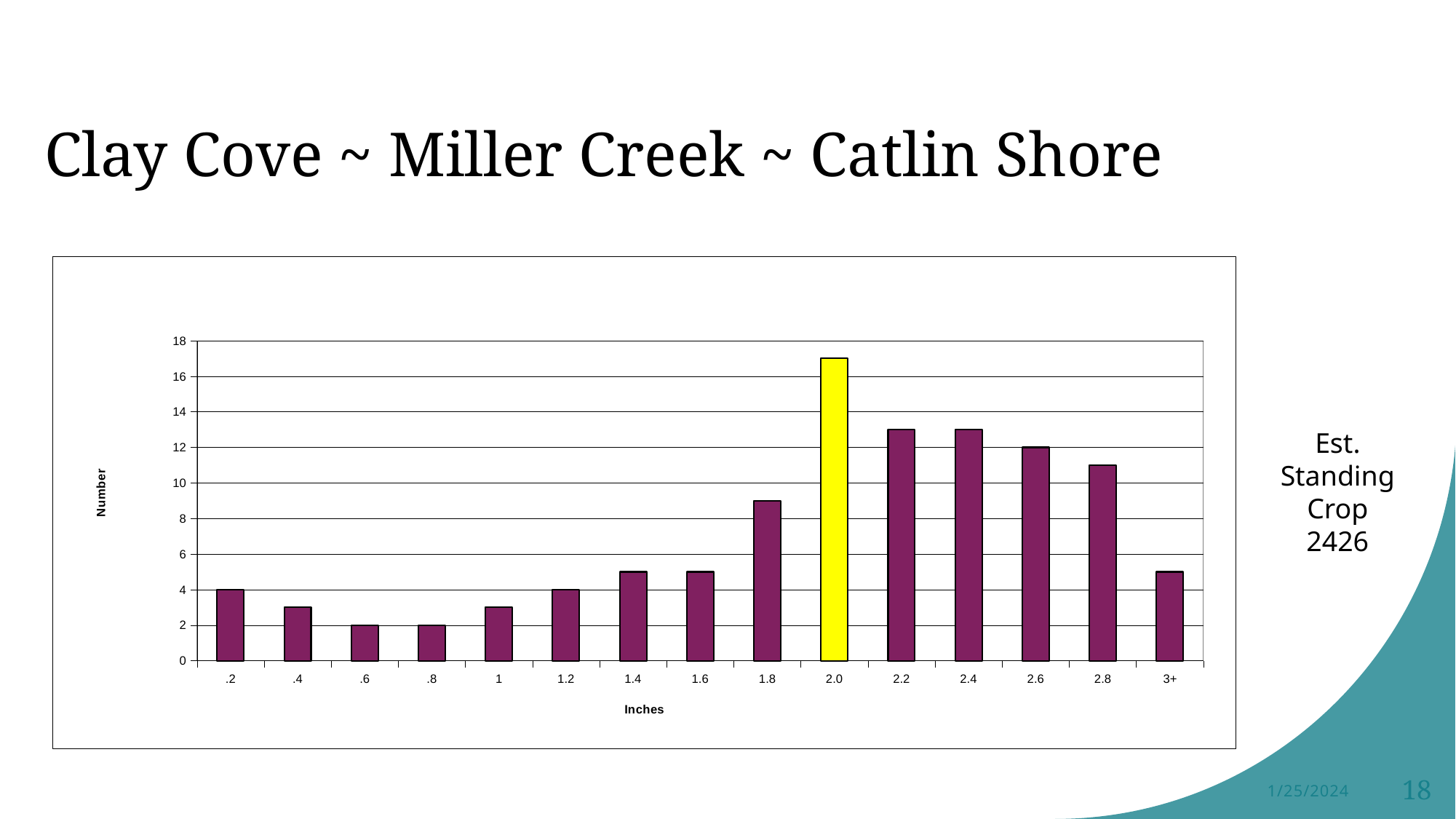
How many categories are shown on the x axis of the chart? 15 Which category has the highest bar in the chart? 2.0 What kind of chart is shown on the slide? bar chart What is the value for the 1.2 category? 4 Which is larger, the value for 2.2 or the value for 3+? 2.2 What is the value for the 2.6 category? 12 What is the value for the .6 category? 2 Do the values rise or fall from the 1.2 category to the 2.0 category? rise Is the value for 2.0 greater or less than 16? greater Is the value for 1.8 greater or less than 10? less What is the title of the x axis of the chart? Inches What is the value for the .2 category? 4